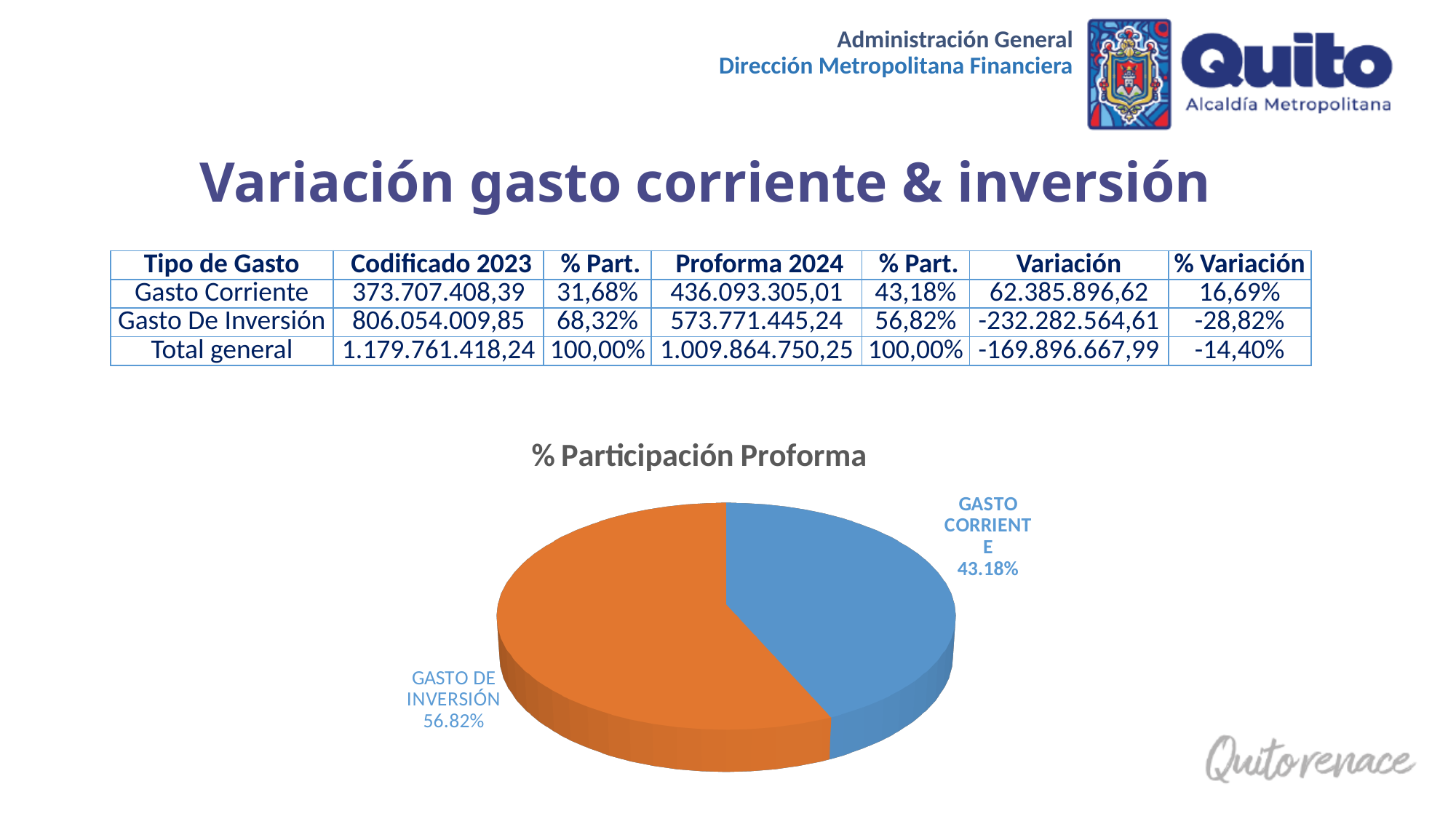
Is the share for GASTO CORRIENTE greater or less than 50%? less How many slices does the pie chart have? 2 Which is larger, the GASTO CORRIENTE slice or the GASTO DE INVERSIÓN slice? GASTO DE INVERSIÓN What colour is the GASTO DE INVERSIÓN slice? Orange What share of the pie does GASTO DE INVERSIÓN represent? 56.82% What is the difference in percentage points between the GASTO DE INVERSIÓN slice and the GASTO CORRIENTE slice? 13.64 Which slice of the pie is the largest? GASTO DE INVERSIÓN What type of chart is shown on the slide? Pie chart Which slice of the pie is the smallest? GASTO CORRIENTE What share of the pie does GASTO CORRIENTE represent? 43.18% What is the title of the chart? % Participación Proforma